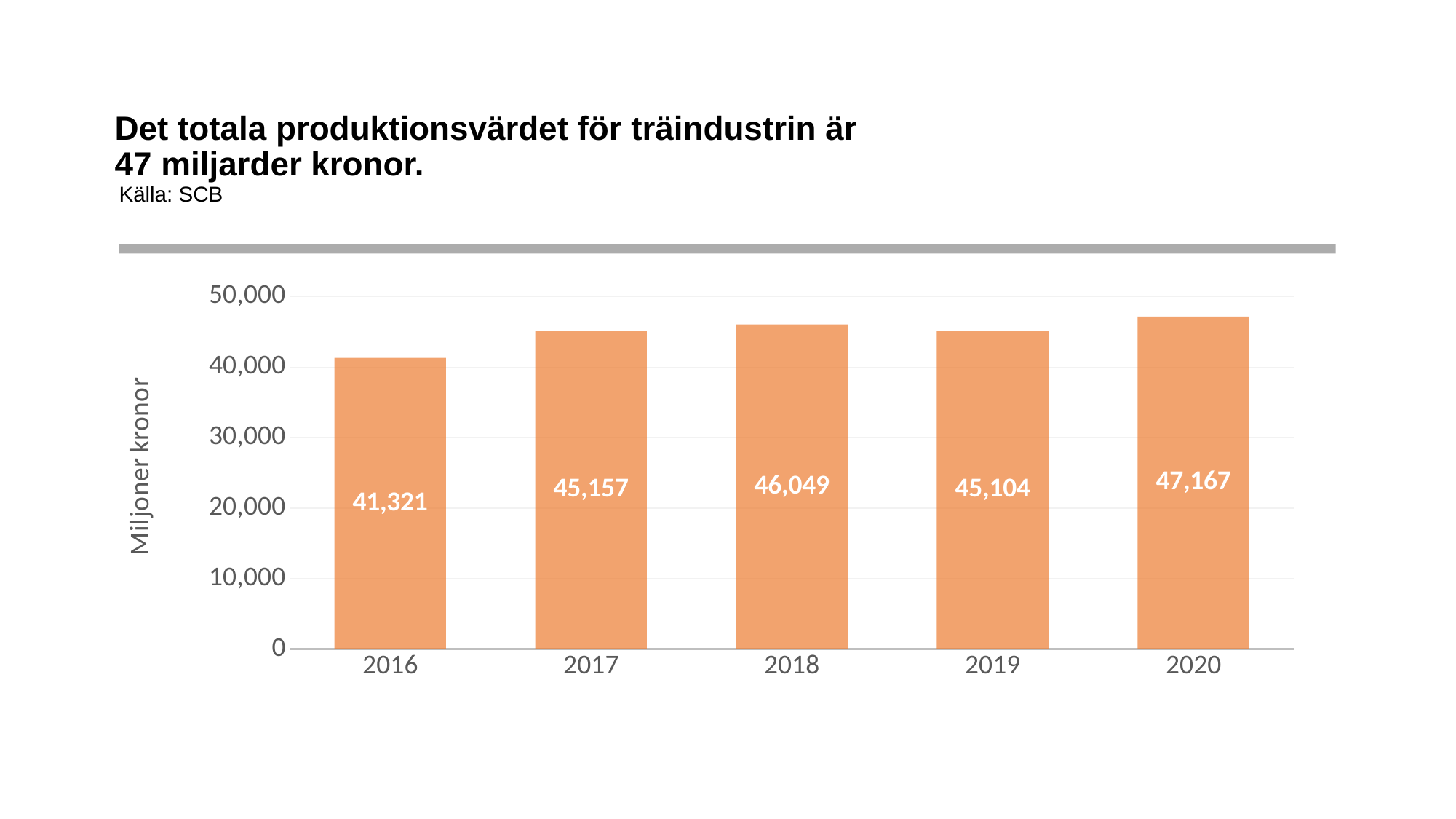
What kind of chart is shown on the slide? bar chart Is the value for 2016 greater or less than 40,000? greater What is the label of the y axis? Miljoner kronor Which is larger, the value for 2018 or the value for 2019? 2018 What is the difference between the values for 2020 and 2016? 5,846 Which year has the highest value? 2020 How many years are shown on the x axis? 5 What is the value for 2018? 46,049 What is the difference between the values for 2018 and 2017? 892 What is the value for 2016? 41,321 What is the value for 2020? 47,167 Which year has the lowest value? 2016